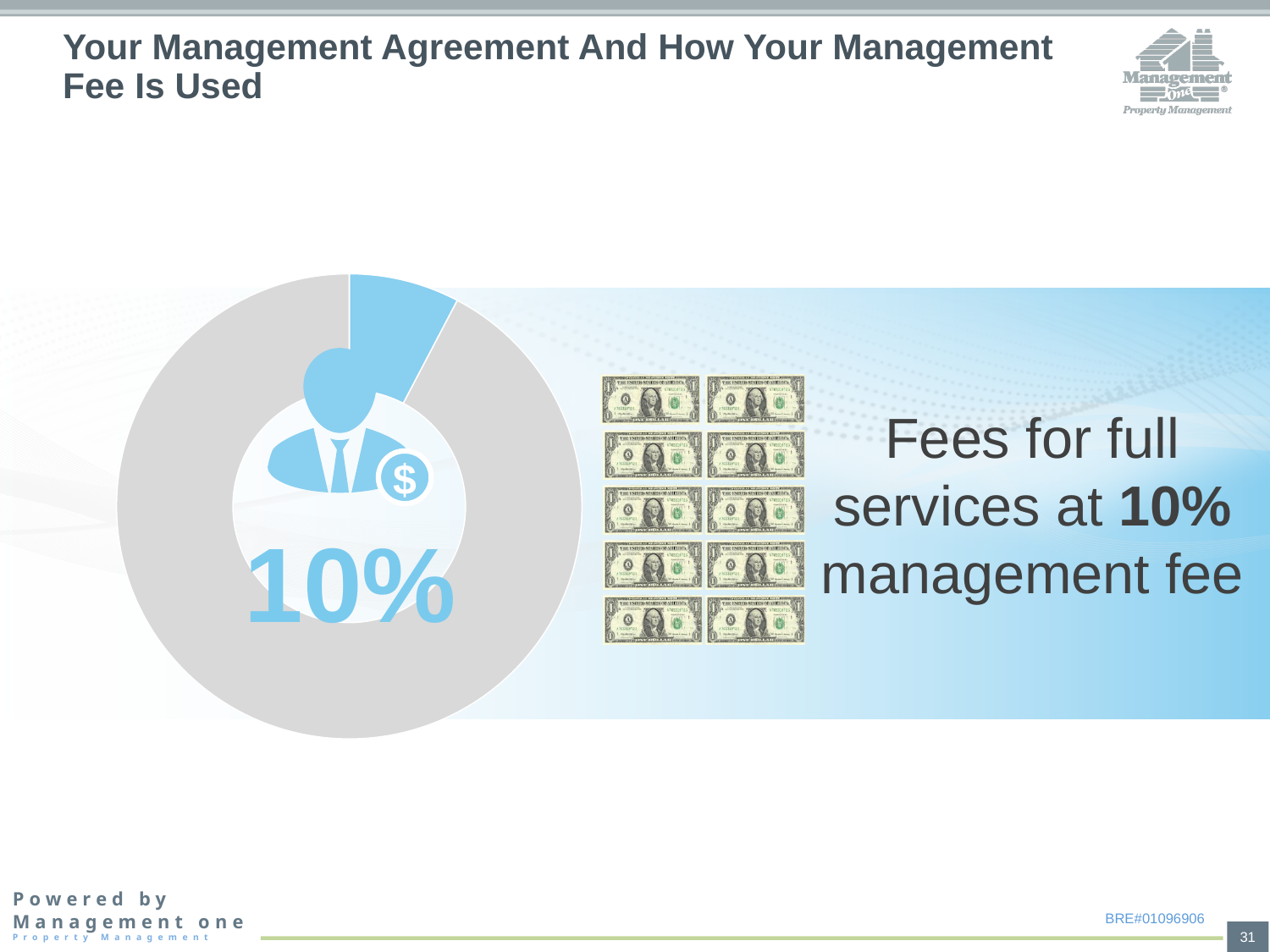
How many slices does the donut chart have? 2 What kind of chart is shown on the slide? Pie chart (donut) What is the title of the slide containing the donut chart? Your Management Agreement And How Your Management Fee Is Used Which slice of the donut chart is larger, the blue slice or the grey slice? The grey slice What colour is the slice representing the 10% management fee? Blue What percentage is printed in the centre of the donut chart? 10% Which slice of the donut chart is the smallest? The blue slice (10%) What share of the donut chart does the blue slice represent? 10%